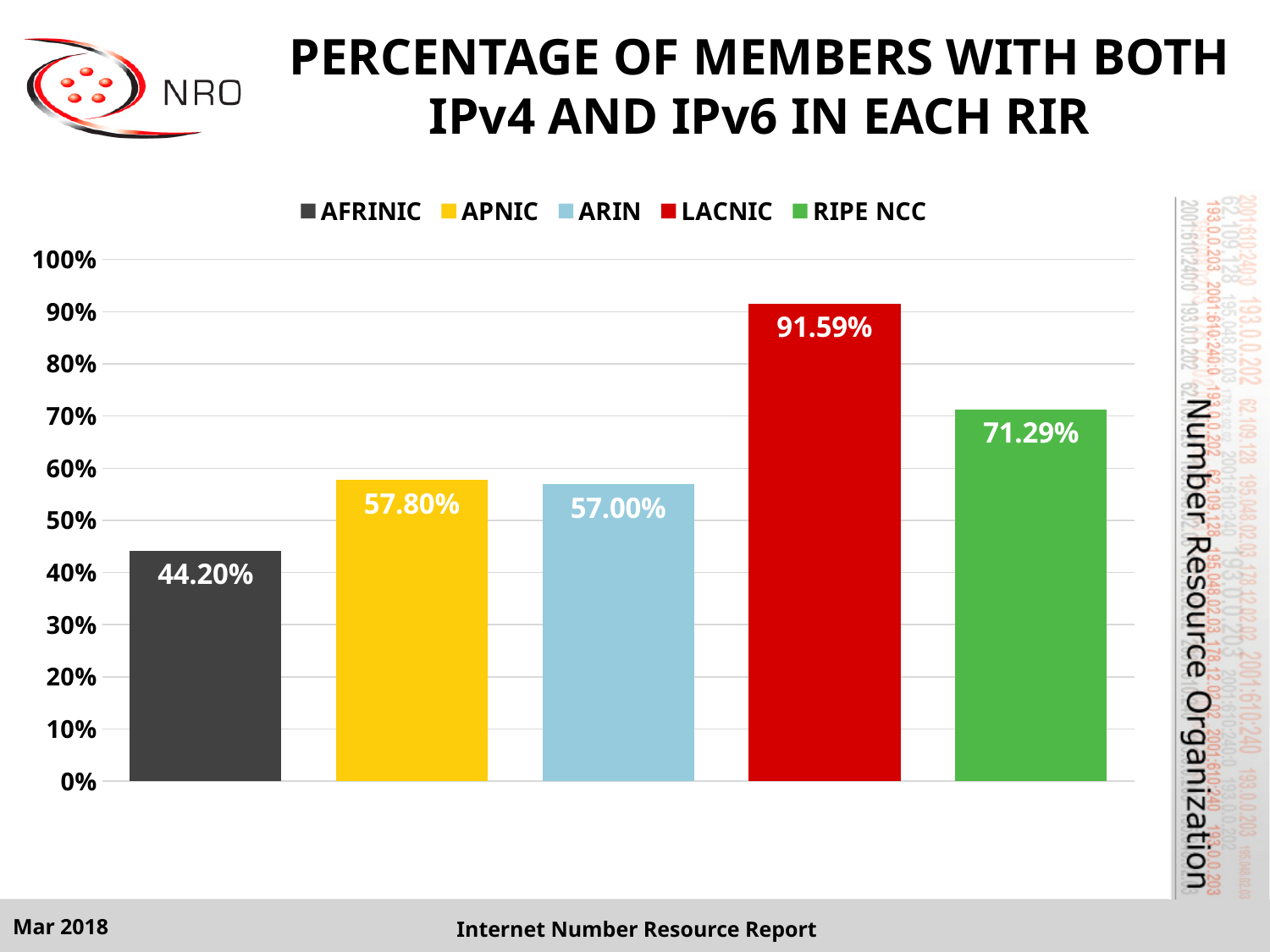
Which is larger, the value for RIPE NCC or the value for APNIC? RIPE NCC What kind of chart is shown on the slide? bar chart Which RIR has the lowest percentage of members with both IPv4 and IPv6? AFRINIC What is the difference between the LACNIC and RIPE NCC values? 20.30% What is the value shown for AFRINIC? 44.20% What is the difference between the APNIC and ARIN values? 0.80% What percentage of LACNIC members have both IPv4 and IPv6? 91.59% Which RIR has the highest percentage of members with both IPv4 and IPv6? LACNIC What is the value shown for RIPE NCC? 71.29% What colour is the bar for LACNIC? red How many RIRs are shown in the chart? 5 Is the value for ARIN greater or less than 60%? less